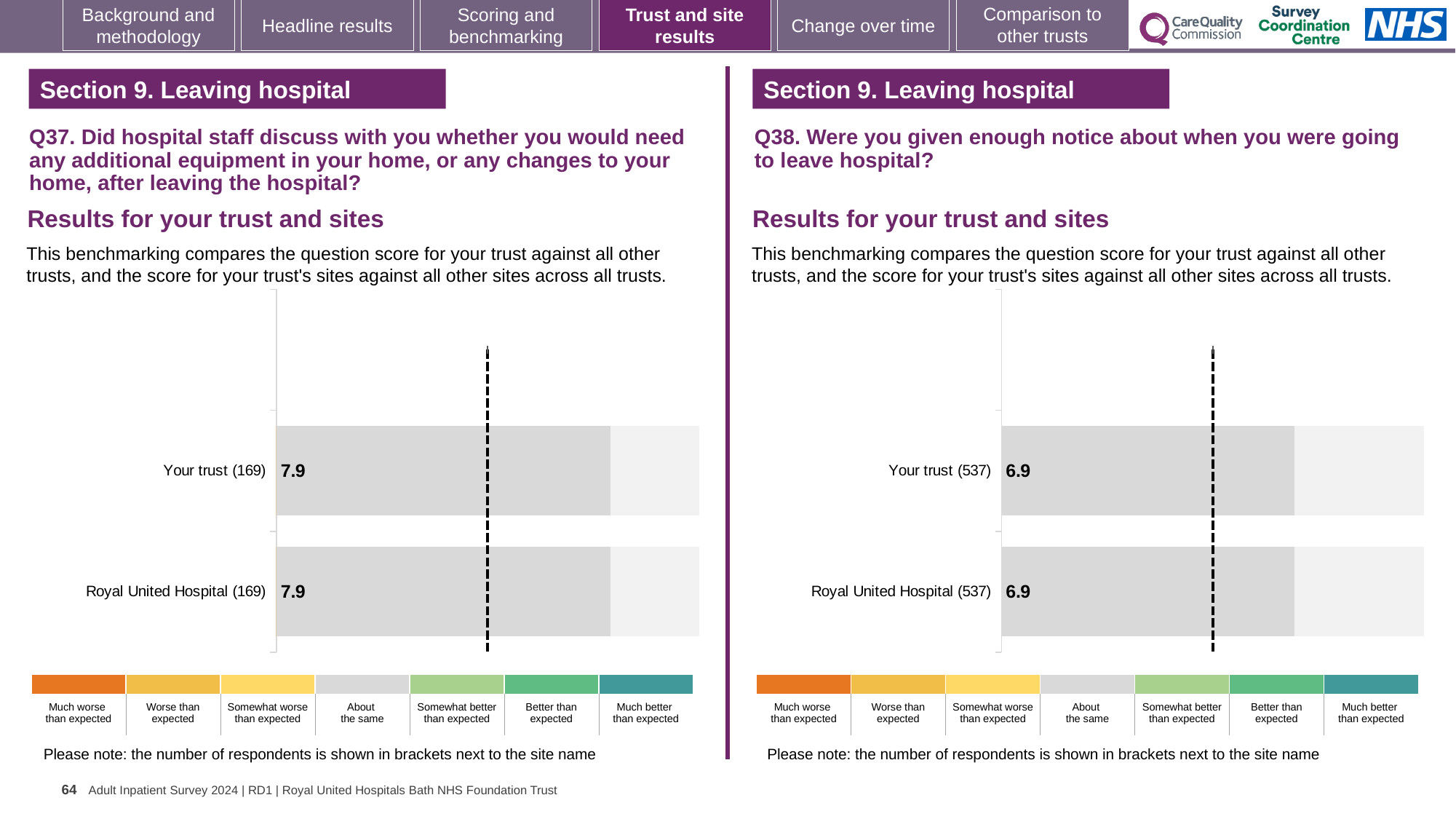
On the Q37 chart (left), how many respondents are shown in brackets for Your trust? 169 How many bars are plotted on the Q38 chart (right)? 2 On the Q38 chart (right), how many respondents are shown in brackets for Royal United Hospital? 537 On the Q37 chart (left), what is the score for Your trust? 7.9 On the Q37 chart (left), what is the score for Royal United Hospital? 7.9 On the Q38 chart (right), what is the score for Your trust? 6.9 What is the difference between the Your trust score on the Q37 chart (left) and the Your trust score on the Q38 chart (right)? 1.0 What kind of chart is used on the Q37 chart (left)? Bar chart How many benchmark categories does the colour key below the Q37 chart (left) list? 7 On the Q37 chart (left), what is the difference between the score for Your trust and the score for Royal United Hospital? 0 On the Q38 chart (right), what is the score for Royal United Hospital? 6.9 Which is larger: the Your trust score on the Q37 chart (left) or the Your trust score on the Q38 chart (right)? Q37 chart (left)